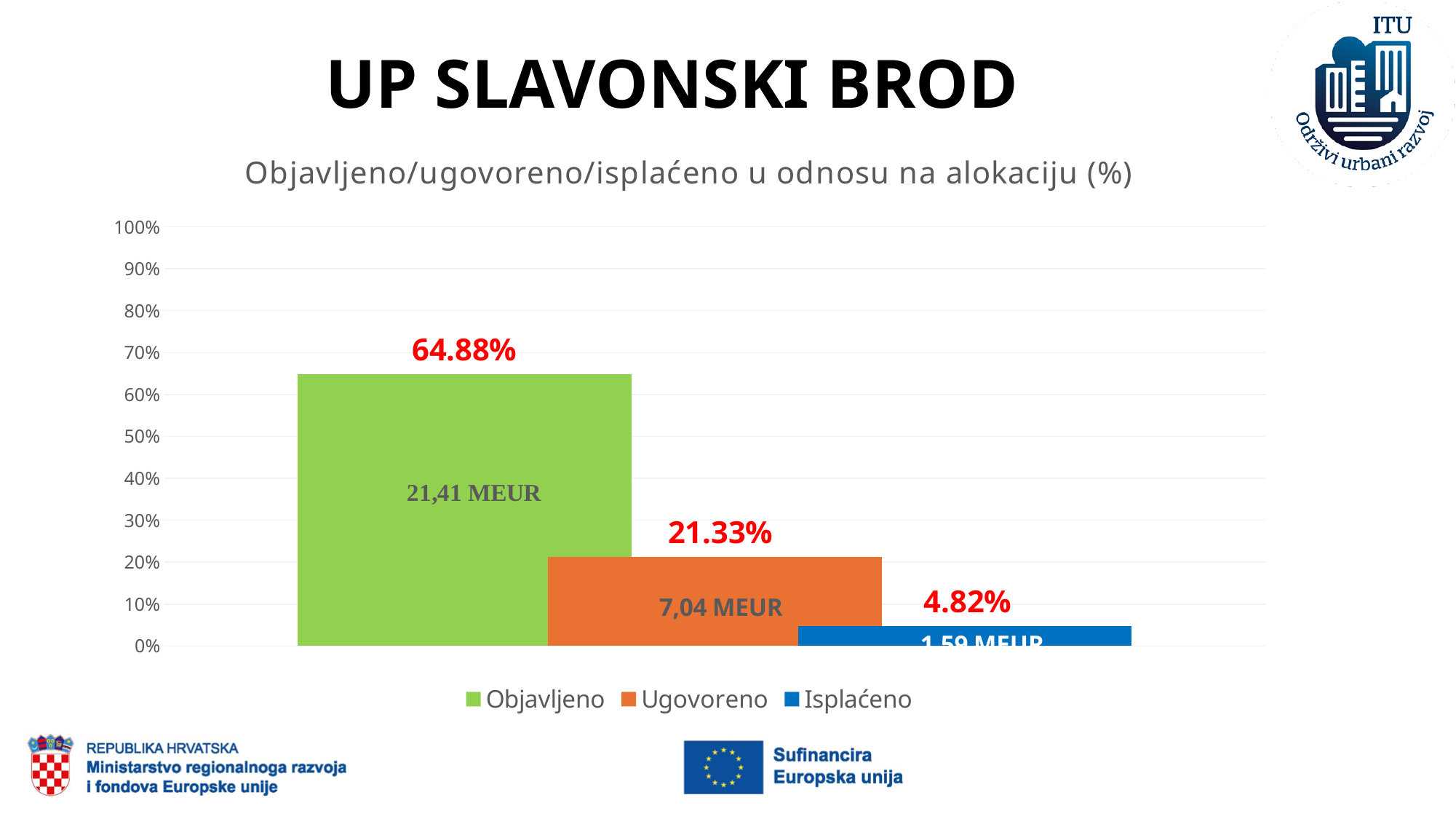
How many series does the legend list? 3 Which series has the highest value? Objavljeno Which is larger, Ugovoreno or Isplaćeno? Ugovoreno What is the value for Isplaćeno? 4.82% What kind of chart is shown on the slide? Bar chart What is the value for Ugovoreno? 21.33% What amount in MEUR is printed on the Ugovoreno bar? 7,04 MEUR What amount in MEUR is printed on the Objavljeno bar? 21,41 MEUR What is the difference in percentage points between Ugovoreno and Isplaćeno? 16.51 What is the value for Objavljeno? 64.88% What is the difference in percentage points between Objavljeno and Ugovoreno? 43.55 Which series has the lowest value? Isplaćeno